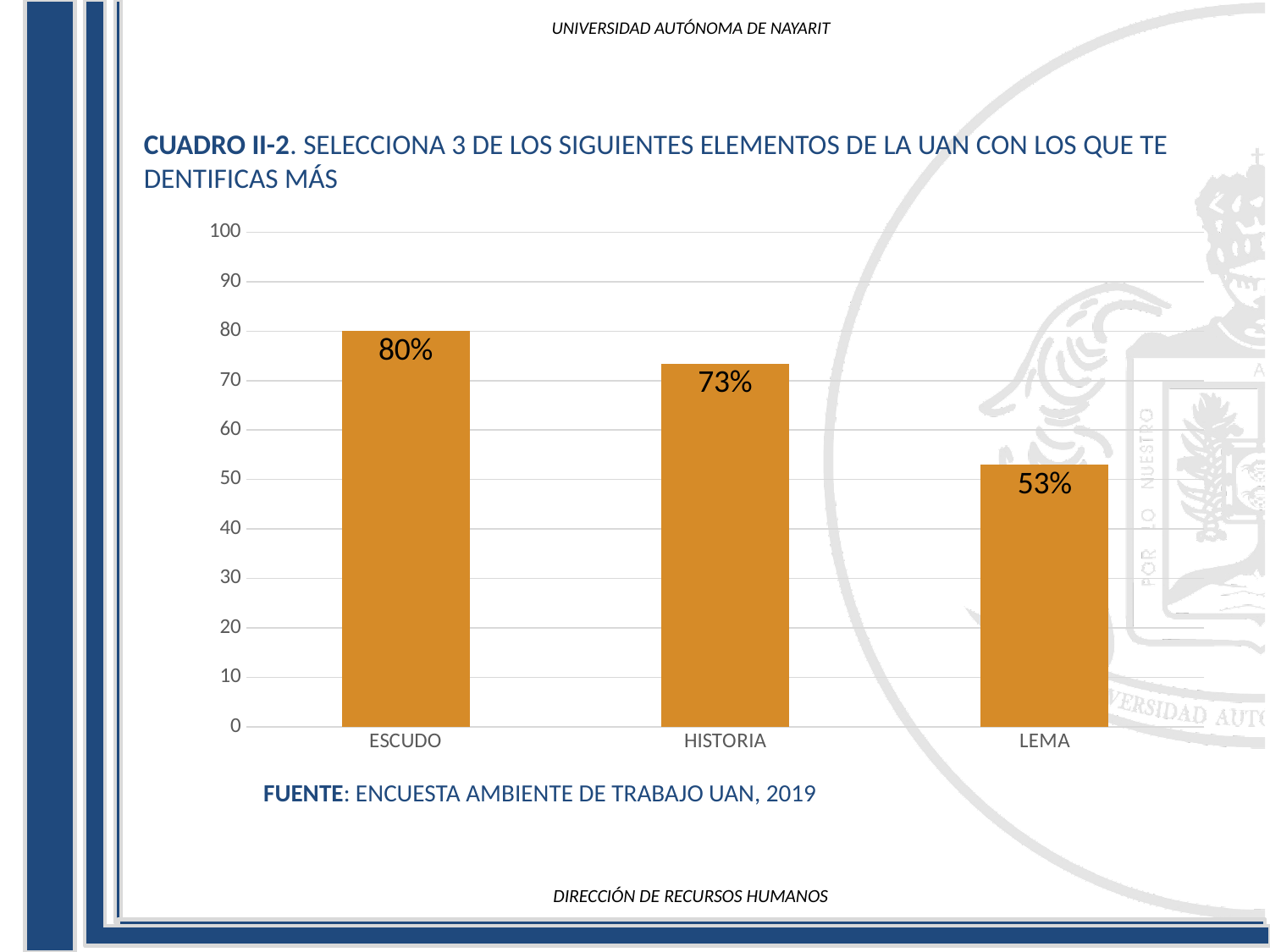
What is the difference between the values for ESCUDO and LEMA? 27% Which category has the lowest value? LEMA Is the value for LEMA greater or less than 60? less Which is larger, the value for HISTORIA or the value for LEMA? HISTORIA What is the difference between the values for HISTORIA and LEMA? 20% What is the value for ESCUDO? 80% Do the values rise or fall from left to right across the categories? fall What kind of chart is shown on the slide? bar chart What is the value for HISTORIA? 73% How many categories are shown on the chart? 3 Which category has the highest value? ESCUDO What is the value for LEMA? 53%